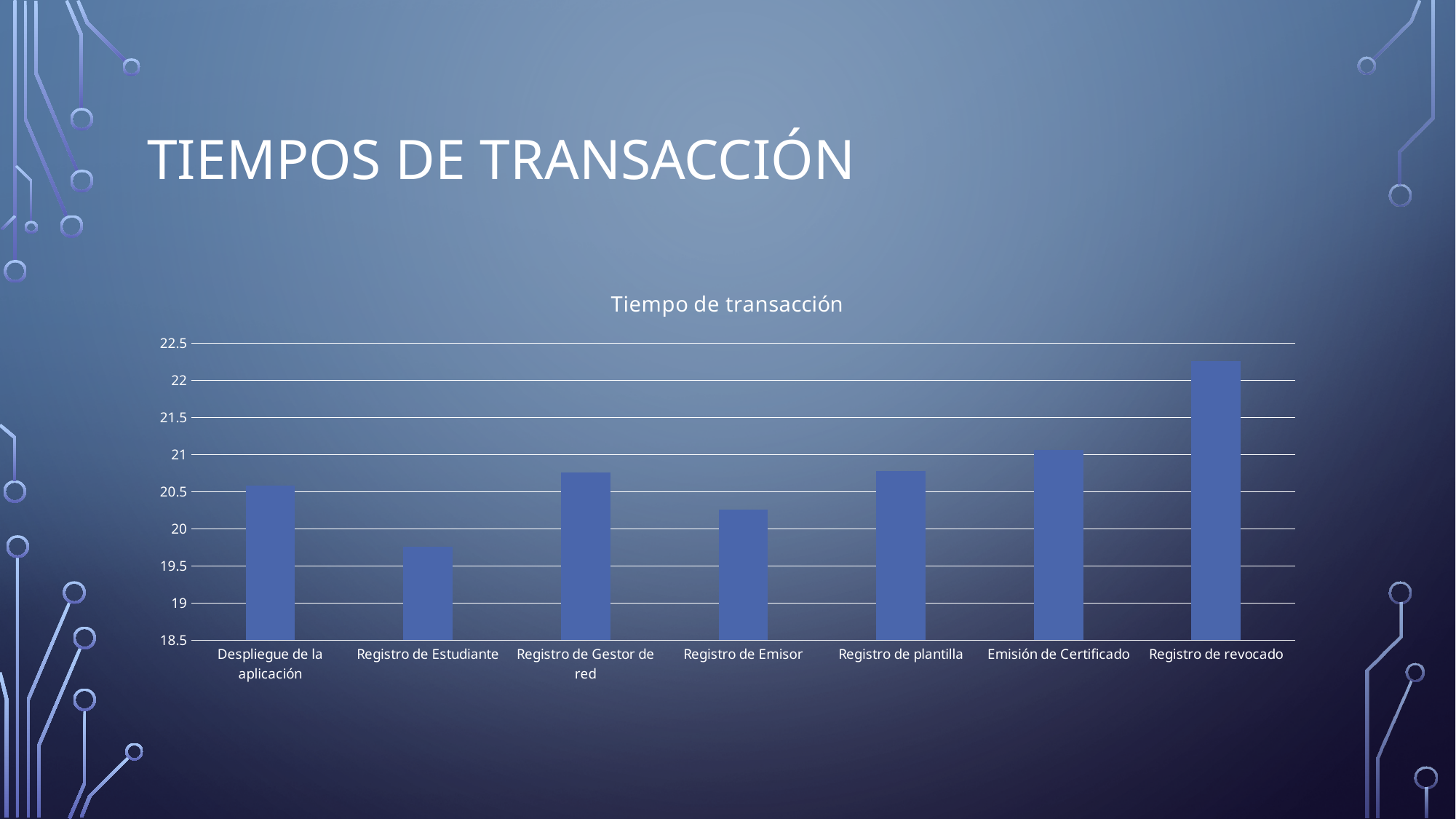
Is the value for Registro de revocado greater or less than 22? greater What kind of chart is shown on the slide? bar chart What is the title of the chart? Tiempo de transacción Which is larger, the value for Emisión de Certificado or the value for Registro de Emisor? Emisión de Certificado Is the value for Despliegue de la aplicación greater or less than 20? greater Is the value for Registro de Estudiante greater or less than 20? less Which category has the lowest transaction time? Registro de Estudiante Which category has the highest transaction time? Registro de revocado How many categories are plotted on the x axis? 7 What is the lowest value shown on the y axis? 18.5